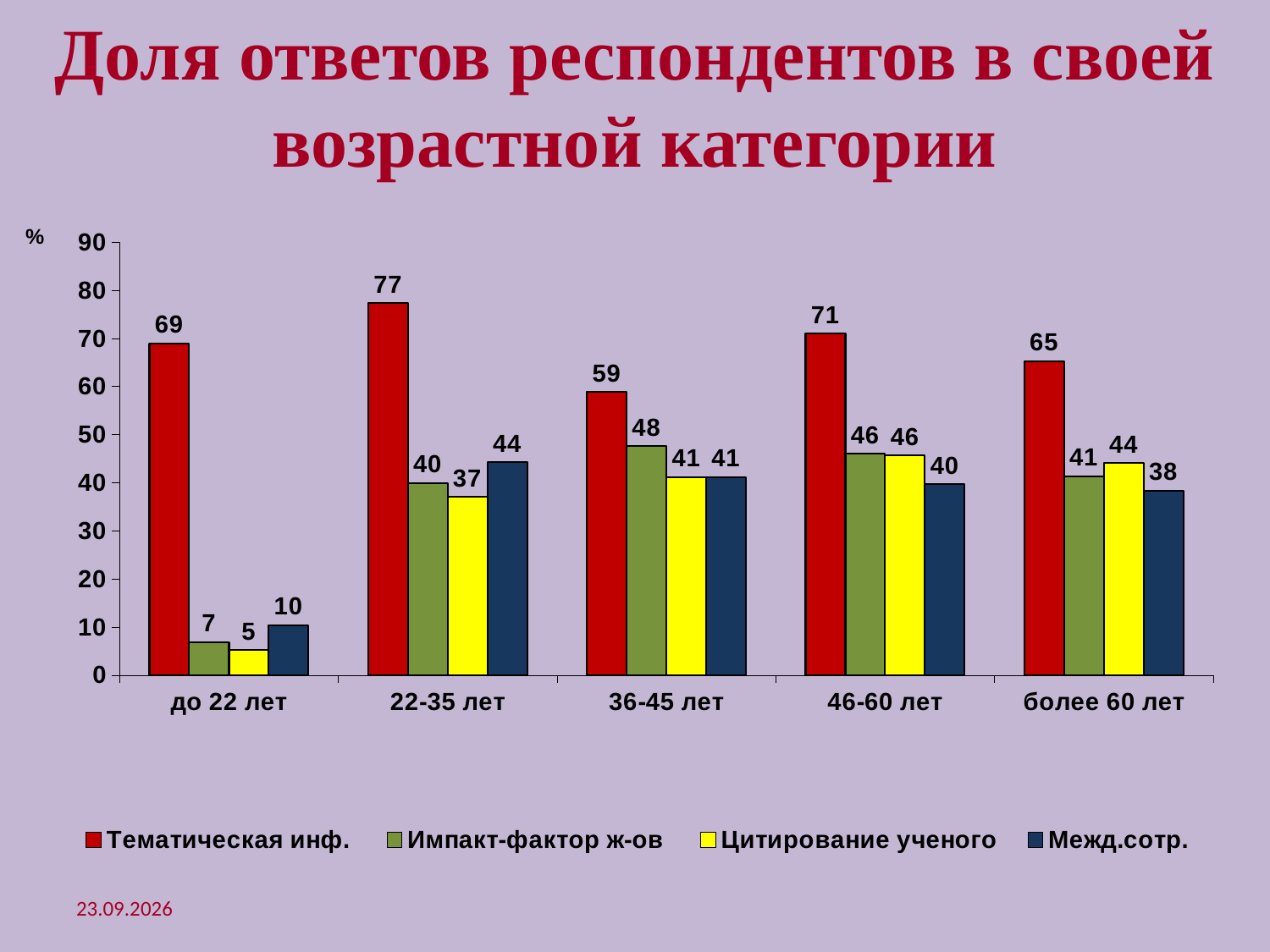
Which age category has the lowest value for Импакт-фактор ж-ов? до 22 лет What is the value for Межд.сотр. in the более 60 лет category? 38 What is the difference between the Тематическая инф. value and the Импакт-фактор ж-ов value in the 36-45 лет category? 11 What is the value for Тематическая инф. in the 22-35 лет category? 77 How many age categories are shown on the x axis? 5 What kind of chart is shown on the slide? bar chart How many series does the legend list? 4 Which is larger in the 22-35 лет category: Цитирование ученого or Межд.сотр.? Межд.сотр. Which age category has the highest value for Тематическая инф.? 22-35 лет Which colour represents Цитирование ученого in the legend? yellow Is the value for Тематическая инф. in the 46-60 лет category greater or less than 60? greater What is the value for Цитирование ученого in the до 22 лет category? 5